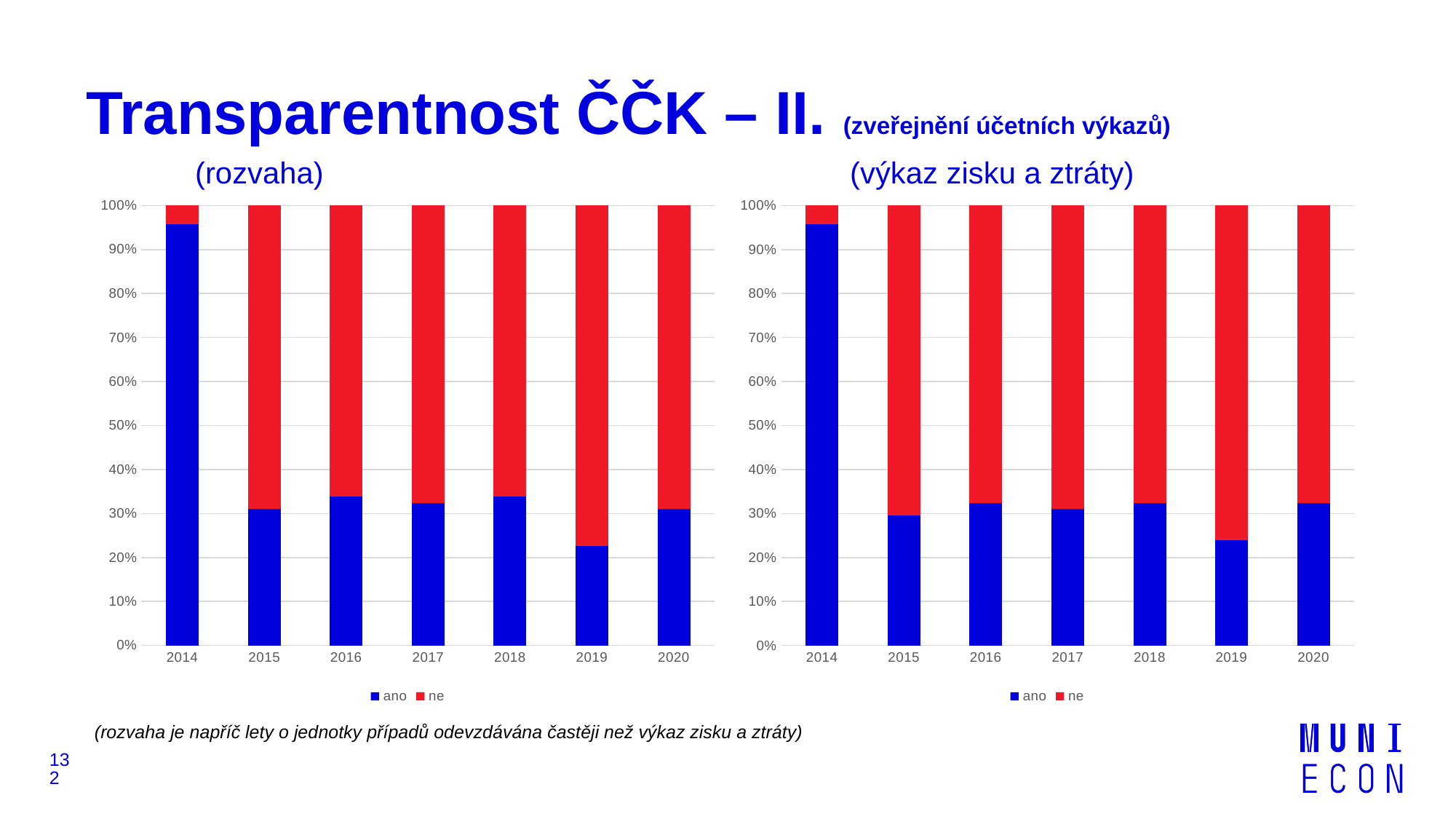
In the left chart titled (rozvaha), is the ano value for 2014 greater or less than 90%? greater How many series does the legend of the left chart titled (rozvaha) list? 2 What are the two legend entries of the right chart titled (výkaz zisku a ztráty)? ano, ne How many years are shown on the x axis of the right chart titled (výkaz zisku a ztráty)? 7 In the right chart titled (výkaz zisku a ztráty), which year has the highest share of ano? 2014 In the right chart titled (výkaz zisku a ztráty), is the ne value for 2015 greater or less than 60%? greater In the left chart titled (rozvaha), which year has the lowest share of ano? 2019 In the left chart titled (rozvaha), which year has the highest share of ano? 2014 In the right chart titled (výkaz zisku a ztráty), which year has the lowest share of ano? 2019 In the right chart titled (výkaz zisku a ztráty), which is larger, the ano share for 2014 or for 2015? 2014 In the left chart titled (rozvaha), is the ano value for 2019 greater or less than 30%? less What kind of chart is the left chart titled (rozvaha)? bar chart